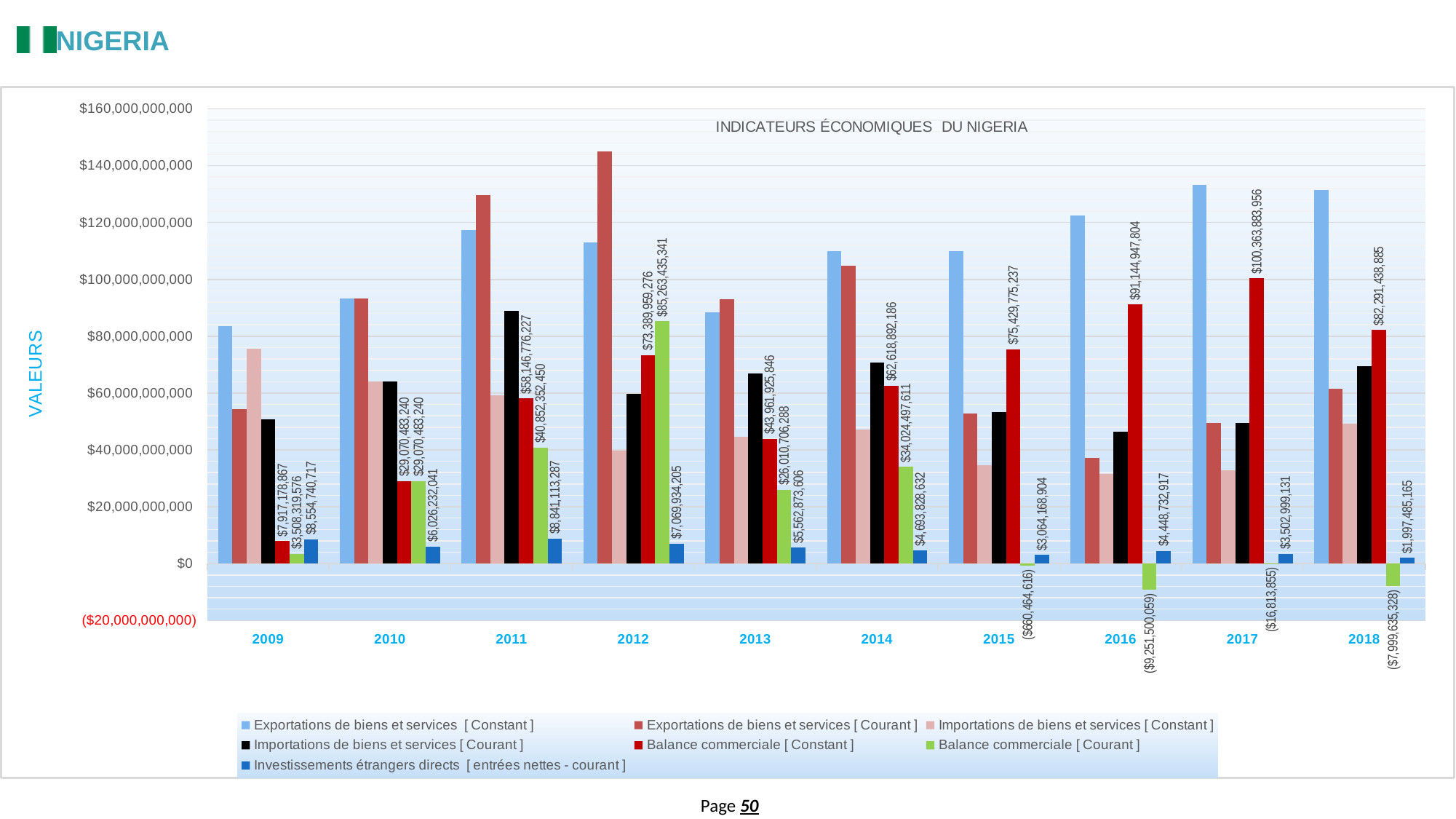
What is the value of Balance commerciale [Courant] in 2016? ($9,251,500,059) What is the difference between Investissements étrangers directs in 2009 and in 2010? $2,528,508,676 What is the value of Investissements étrangers directs in 2011? $8,841,113,287 What is the value of Balance commerciale [Constant] in 2017? $100,363,883,956 How many series does the chart's legend list? 7 Is the value of Exportations de biens et services [Constant] in 2017 greater or less than $120,000,000,000? greater Which year has the larger Balance commerciale [Constant], 2016 or 2018? 2016 In which year is Balance commerciale [Constant] the highest? 2017 In which year is Investissements étrangers directs the lowest? 2018 What kind of chart is shown on the slide? Bar chart How many years are shown on the x axis of the chart? 10 What is the title of the chart? INDICATEURS ÉCONOMIQUES DU NIGERIA